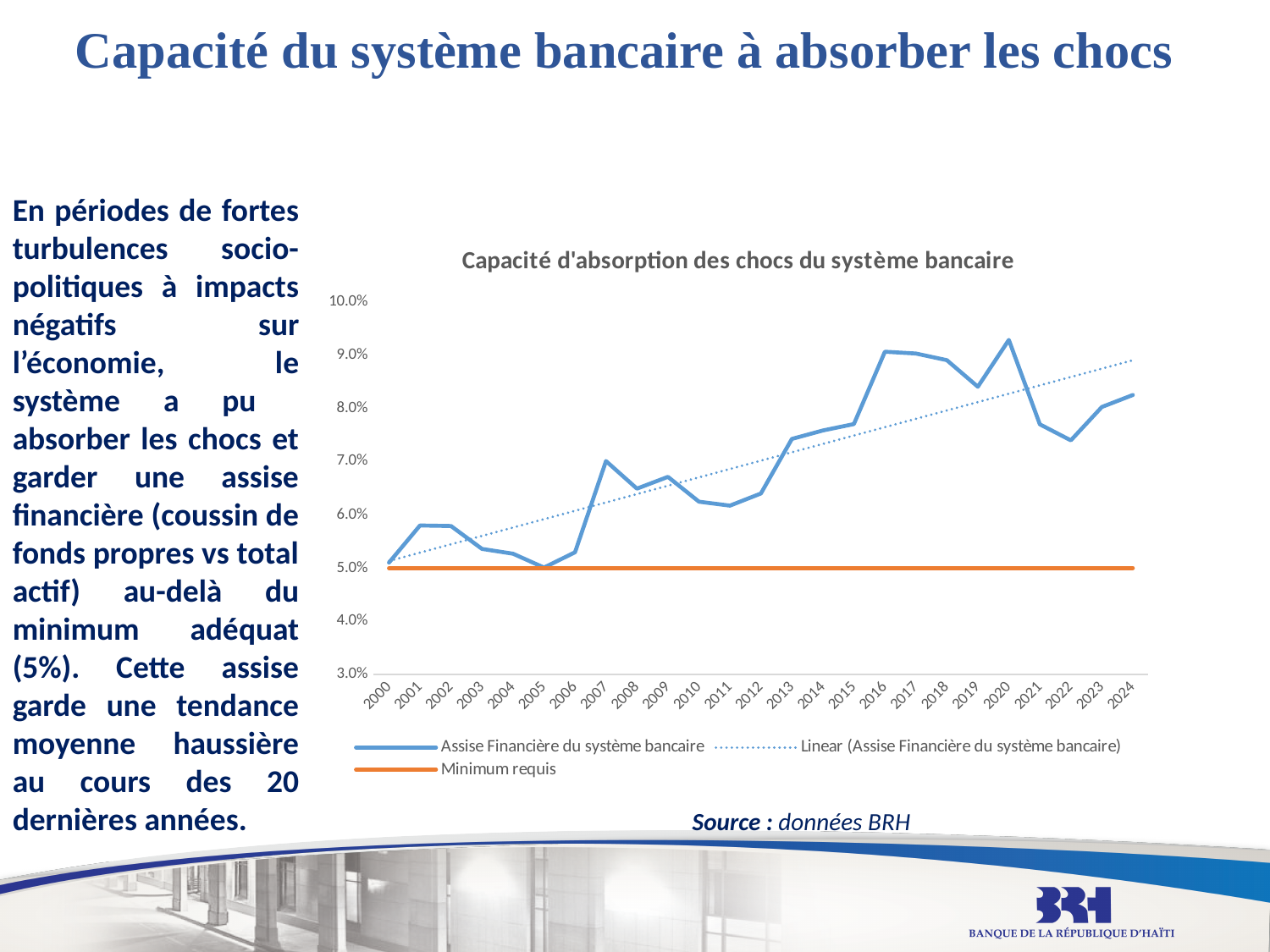
How many series does the chart legend list? 3 Is the value for 'Assise Financière du système bancaire' in 2005 greater or less than 6.0%? less How many years are plotted along the x axis of the chart? 25 What is the title of the chart? Capacité d'absorption des chocs du système bancaire In which year does the 'Assise Financière du système bancaire' series reach its highest value? 2020 Is the value for 'Assise Financière du système bancaire' in 2016 greater or less than 8.0%? greater Which year has the larger value for 'Assise Financière du système bancaire', 2005 or 2016? 2016 Is the value for 'Assise Financière du système bancaire' in 2007 greater or less than 6.0%? greater Does the 'Assise Financière du système bancaire' series generally rise or fall from 2000 to 2024? rise What is the value of the 'Minimum requis' line? 5.0% What kind of chart is shown on the slide? line chart